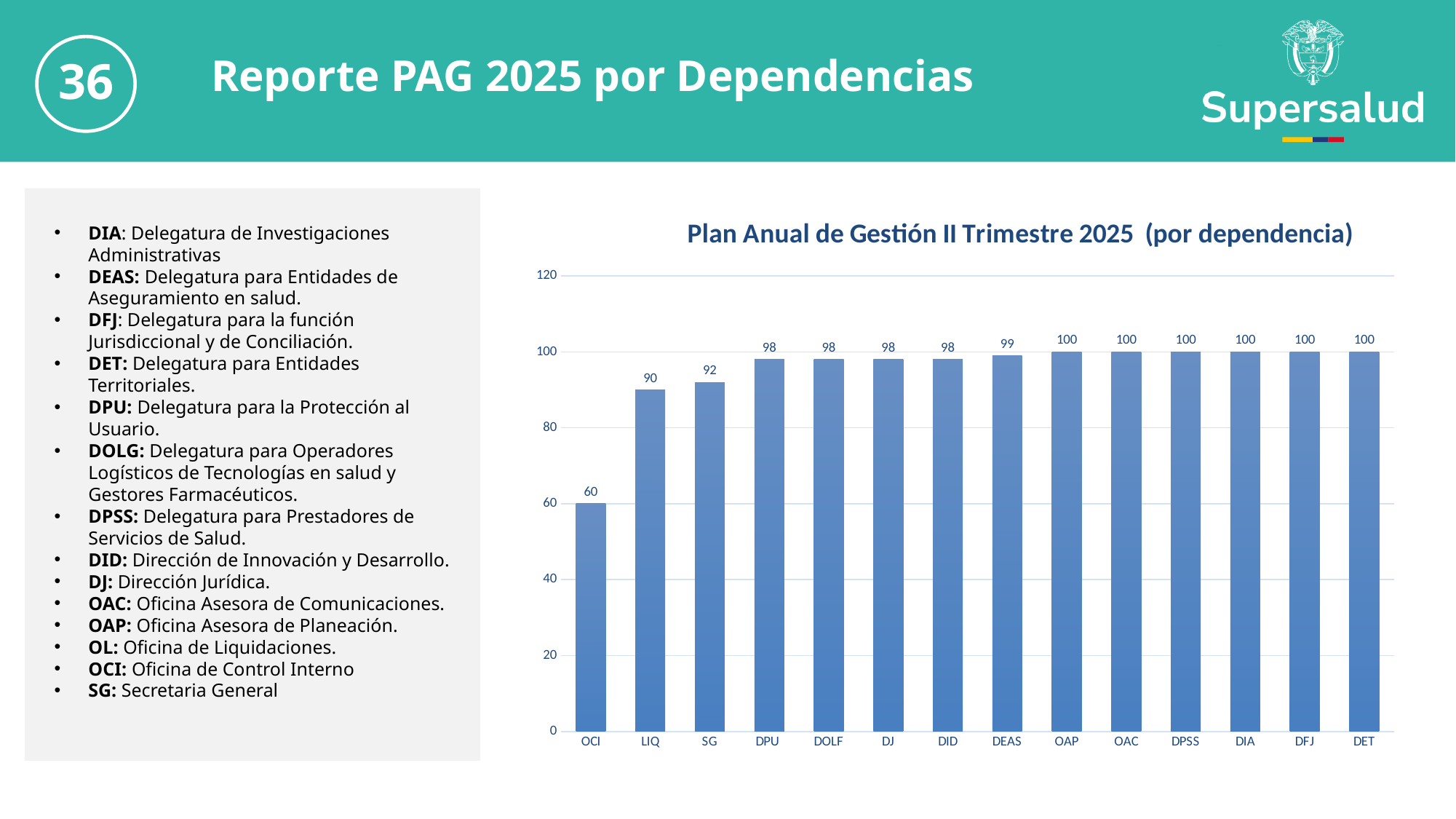
What is the value for LIQ? 90 Which dependency has the lowest value? OCI How many dependencies are shown on the x axis? 14 What is the difference between the values for LIQ and OCI? 30 What is the difference between the values for DET and SG? 8 What is the value for OCI? 60 Is the value for OCI greater or less than 80? less What is the value for SG? 92 What is the value for DPU? 98 Which is larger, the value for SG or the value for LIQ? SG What kind of chart is shown on the slide? bar chart What is the value for DEAS? 99